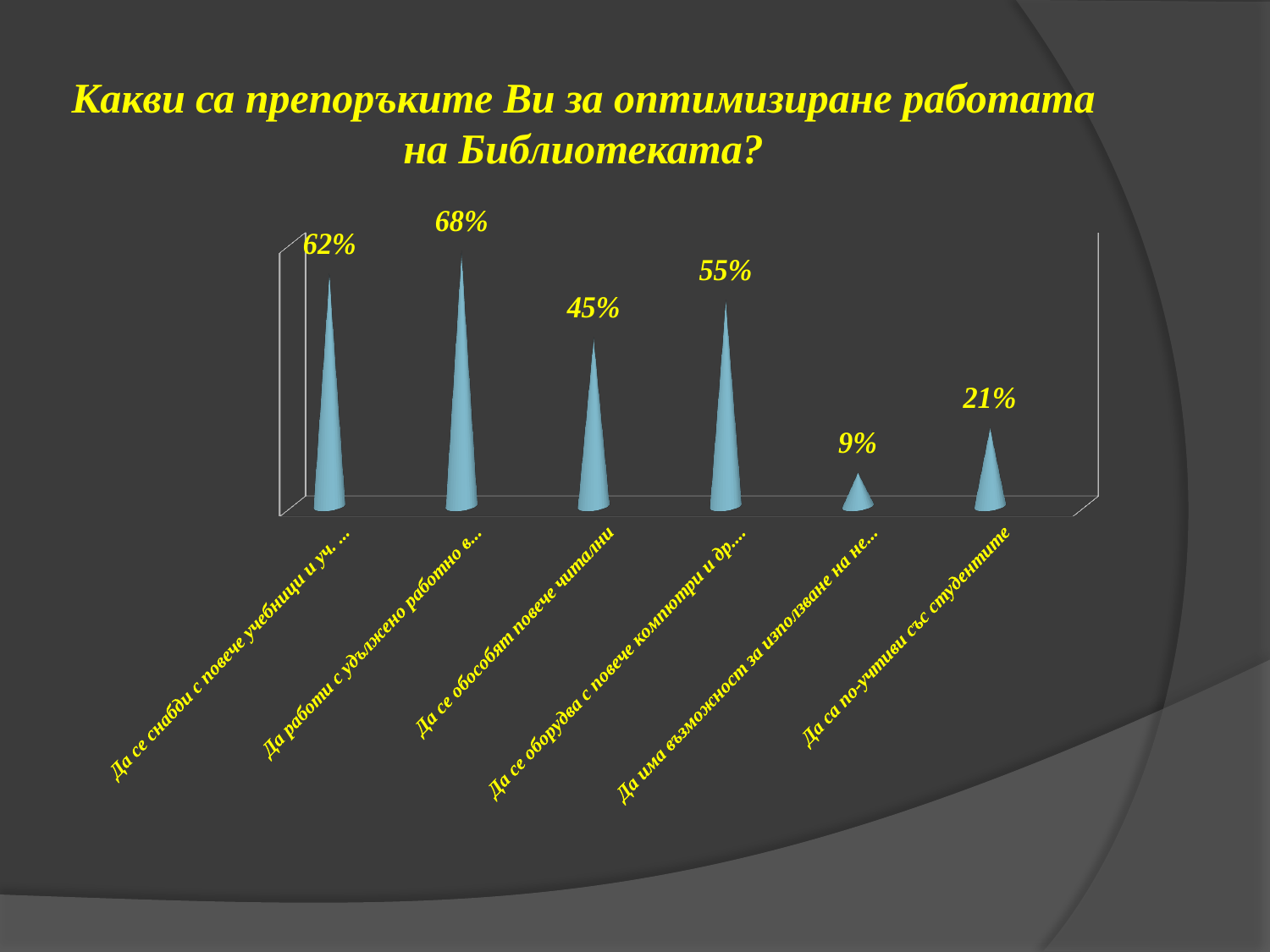
Which category has the lowest value? Да има възможност за използване на не... Which category has the highest value? Да работи с удължено работно в... What is the title of the slide above the chart? Какви са препоръките Ви за оптимизиране работата на Библиотеката? What value is shown for the category "Да са по-учтиви със студентите"? 21% What is the difference between the values for "Да са по-учтиви със студентите" and "Да има възможност за използване на не..."? 12% What value is shown for the category beginning "Да работи с удължено работно в..."? 68% What is the difference between the values for "Да работи с удължено работно в..." and "Да се снабди с повече учебници и уч. ..."? 6% What kind of chart is shown on the slide? Bar chart Which is larger: the value for "Да се оборудва с повече компютри и др...." or the value for "Да се обособят повече читални"? Да се оборудва с повече компютри и др.... What value is shown for the category beginning "Да има възможност за използване на не..."? 9% How many categories are plotted in the chart? 6 What value is shown for the category "Да се обособят повече читални"? 45%